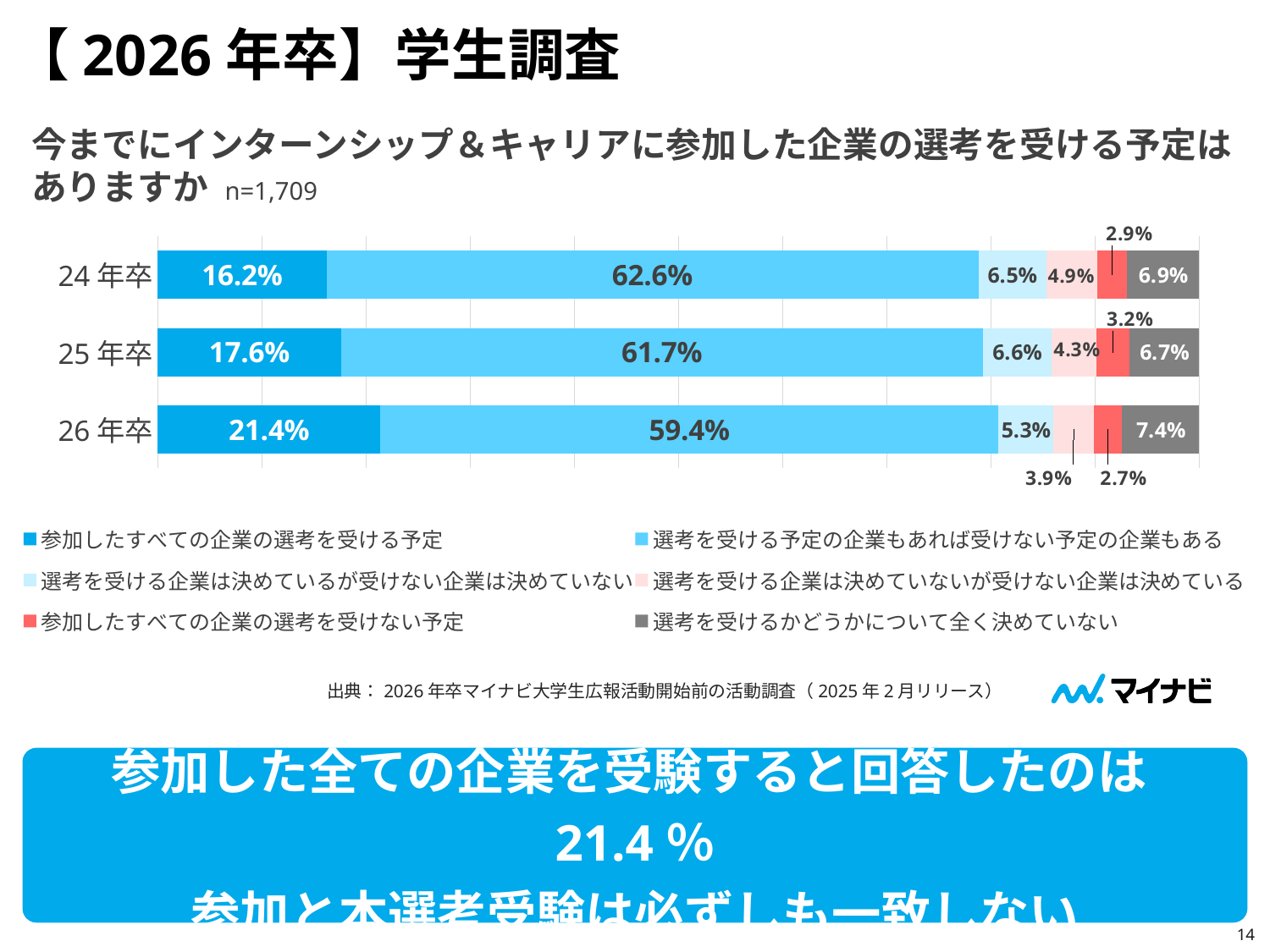
Does the series 参加したすべての企業の選考を受ける予定 rise or fall from 24年卒 to 26年卒? Rise What is the value for 26年卒 in the series 参加したすべての企業の選考を受ける予定? 21.4% What is the value for 25年卒 in the series 参加したすべての企業の選考を受けない予定? 3.2% How many series does the legend list? 6 Which graduation year has the highest value for 参加したすべての企業の選考を受ける予定? 26年卒 Which graduation year has the lowest value for 選考を受ける予定の企業もあれば受けない予定の企業もある? 26年卒 What is the sample size (n) shown for the survey question? n=1,709 What kind of chart is shown on the slide? Stacked bar chart How many categories (graduation years) are plotted in the chart? 3 What is the value for 24年卒 in the series 選考を受ける予定の企業もあれば受けない予定の企業もある? 62.6% What is the difference between the 26年卒 and 24年卒 values for 参加したすべての企業の選考を受ける予定? 5.2% What is the value for 26年卒 in the series 選考を受けるかどうかについて全く決めていない? 7.4%